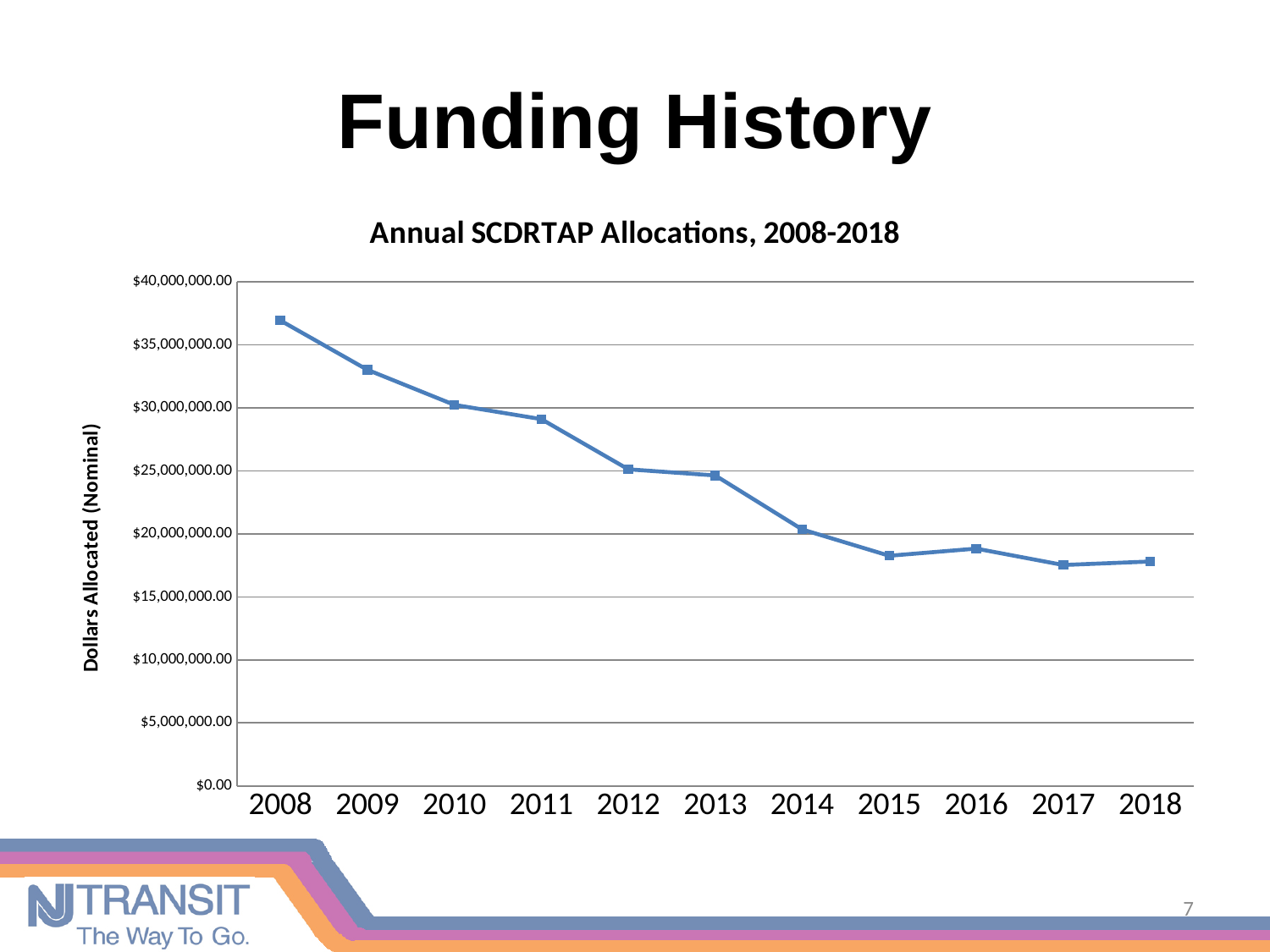
What is the label on the vertical axis of the chart? Dollars Allocated (Nominal) Which year has the larger allocation, 2018 or 2008? 2008 Do the allocations generally rise or fall from 2008 to 2018? fall Is the value for 2009 greater or less than $35,000,000.00? less What kind of chart is shown on the slide? line chart Is the value for 2011 greater or less than $30,000,000.00? less How many years are plotted on the chart? 11 Is the value for 2015 greater or less than $20,000,000.00? less Which year has the highest allocation? 2008 Which year has the larger allocation, 2010 or 2014? 2010 What is the title of the chart? Annual SCDRTAP Allocations, 2008-2018